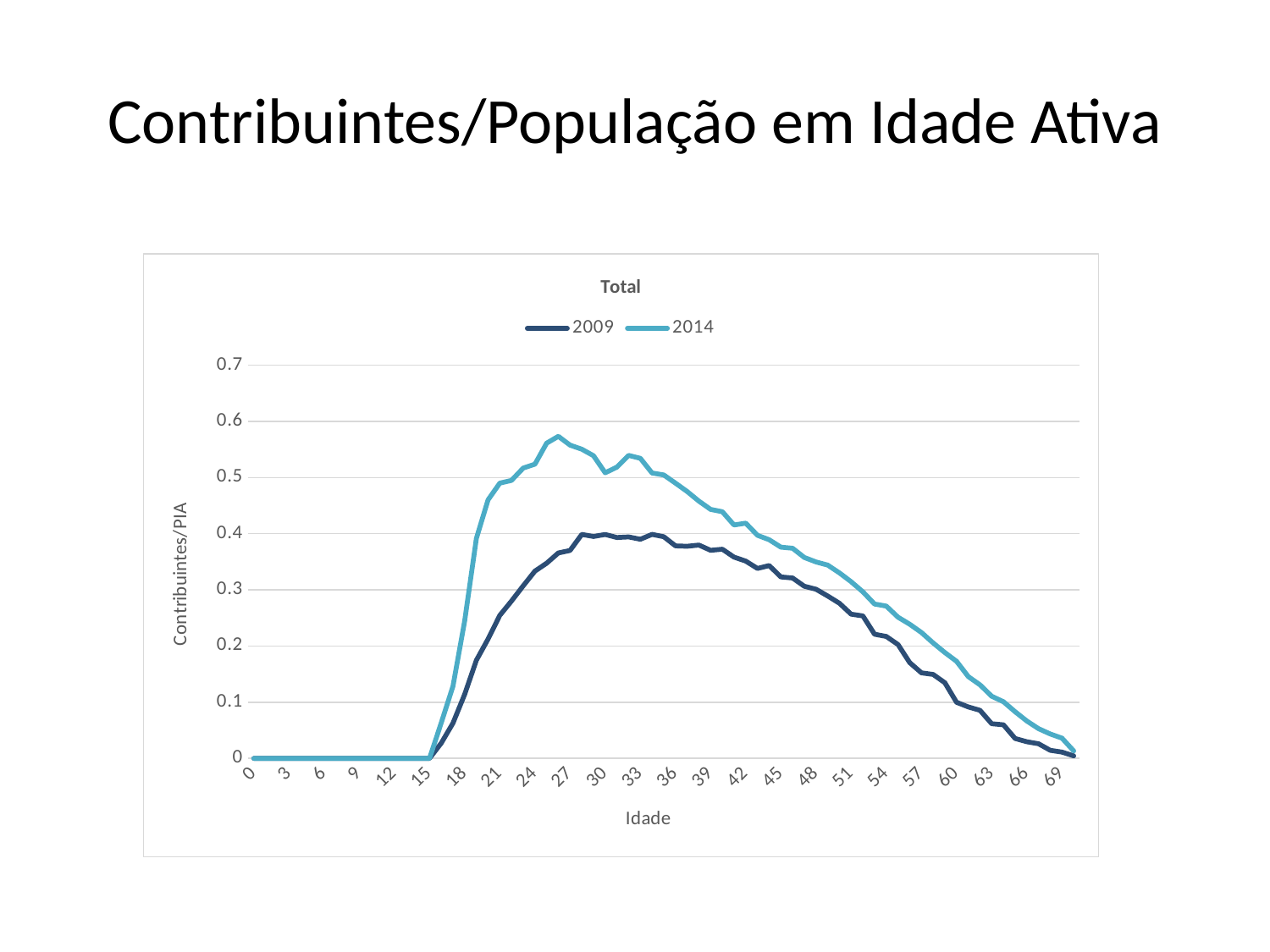
At age 30, which series has the higher value, 2009 or 2014? 2014 What is the label on the vertical axis of the chart? Contribuintes/PIA Is the value for the 2009 series at age 30 greater or less than 0.5? less Is the value for the 2014 series at age 27 greater or less than 0.5? greater Between age 15 and age 27, do the values of the 2014 series rise or fall? rise How many series does the legend list? 2 What is the value of the 2009 series at age 9? 0 Is the value for the 2009 series at age 60 greater or less than 0.2? less What is the title printed above the chart's legend? Total Between age 36 and age 69, do the values of the 2014 series rise or fall? fall What kind of chart is shown on the slide? line chart